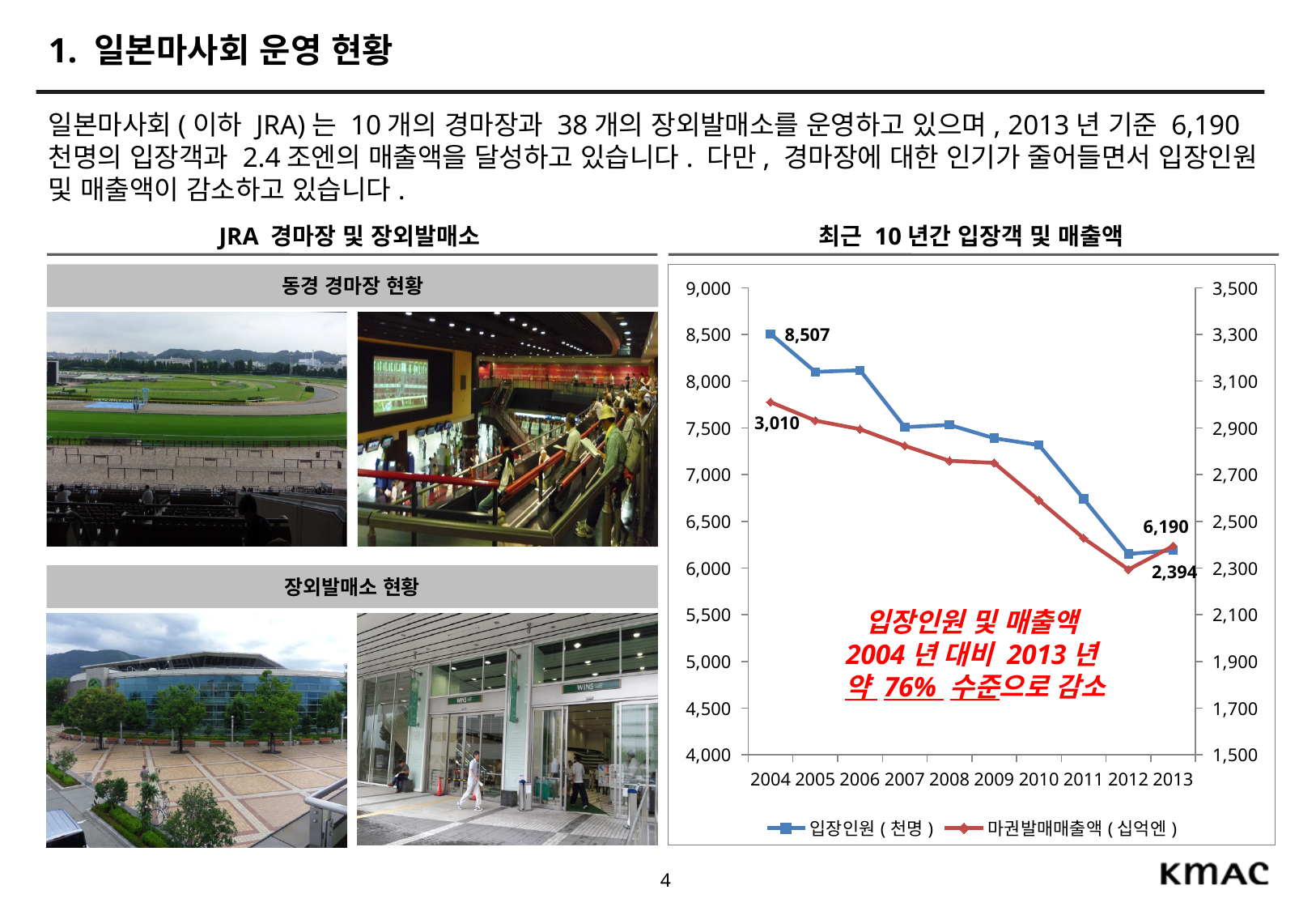
How many series does the chart's legend list? 2 Does 입장인원 (천명) generally rise or fall from 2004 to 2013? Fall What is the value of 입장인원 (천명) in 2004? 8,507 How many years are plotted on the x axis of the chart? 10 What is the value of 마권발매매출액 (십억엔) in 2013? 2,394 What kind of chart is shown on the slide? Line chart What is the value of 입장인원 (천명) in 2013? 6,190 By how much did 입장인원 (천명) decrease from 2004 to 2013? 2,317 By how much did 마권발매매출액 (십억엔) decrease from 2004 to 2013? 616 Is the value of 입장인원 (천명) in 2008 greater or less than 7,000? greater Which year has the highest 입장인원 (천명)? 2004 What is the value of 마권발매매출액 (십억엔) in 2004? 3,010